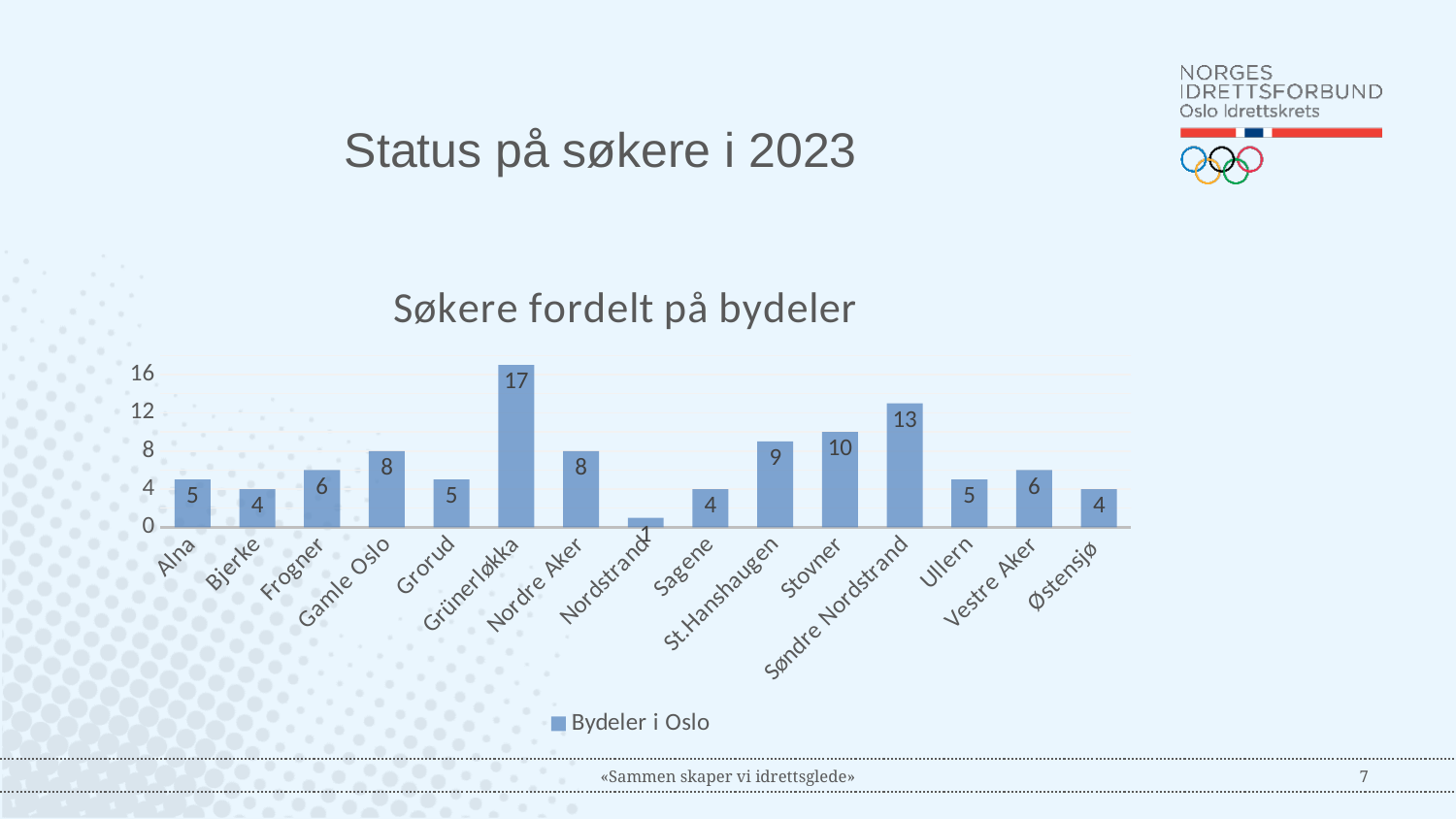
Is the value for Søndre Nordstrand greater or less than 12? greater What is the value for Søndre Nordstrand? 13 Which is larger, the value for St.Hanshaugen or the value for Gamle Oslo? St.Hanshaugen What is the difference between the values for Grünerløkka and Søndre Nordstrand? 4 Which bydel has the lowest number of søkere? Nordstrand What is the value for Grünerløkka? 17 Which bydel has the highest number of søkere? Grünerløkka How many series does the legend list? 1 What is the value for Stovner? 10 What is the title of the chart? Søkere fordelt på bydeler How many bydeler are shown on the x axis? 15 What kind of chart is shown? bar chart